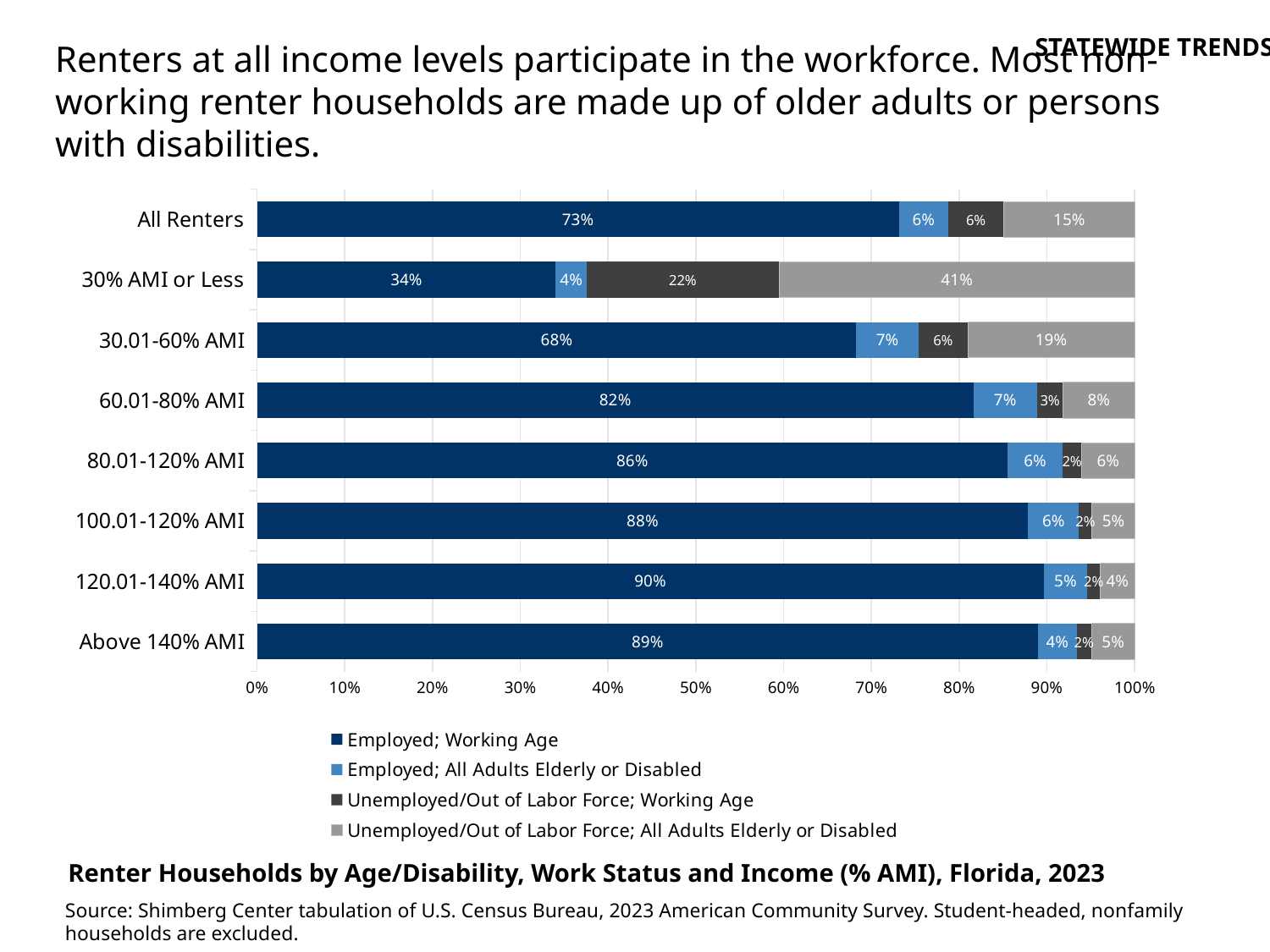
What type of chart is shown on the slide? Stacked bar chart How many income categories are shown on the chart? 8 What is the Unemployed/Out of Labor Force; Working Age value for the 30.01-60% AMI group? 6% Which income group has the highest Employed; Working Age share? 120.01-140% AMI What percentage of All Renters are Employed; Working Age? 73% What share of renters at 30% AMI or Less are Unemployed/Out of Labor Force; All Adults Elderly or Disabled? 41% Which is larger: the Employed; Working Age share for 30.01-60% AMI or for 60.01-80% AMI? 60.01-80% AMI How many percentage points higher is the Unemployed/Out of Labor Force; All Adults Elderly or Disabled share for 30% AMI or Less than for All Renters? 26 percentage points How many series does the legend list? 4 Which income group has the lowest Employed; Working Age share? 30% AMI or Less What is the Employed; All Adults Elderly or Disabled value for the 60.01-80% AMI group? 7% What is the total of the stacked bar for All Renters? 100%